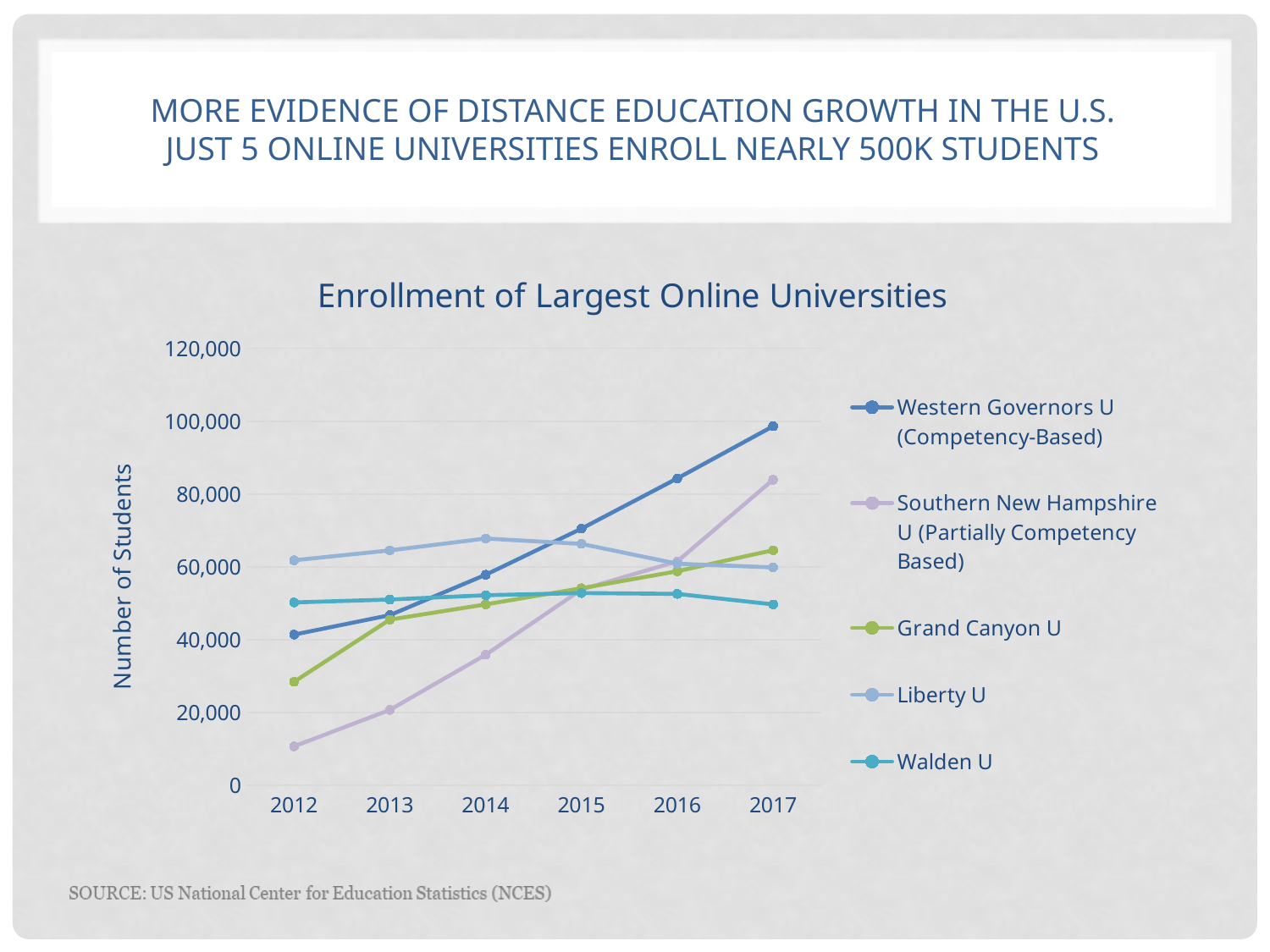
What is the title of the chart? Enrollment of Largest Online Universities Which university has the highest enrollment in 2017? Western Governors U (Competency-Based) What is the label on the y axis? Number of Students Which university has the lowest enrollment in 2012? Southern New Hampshire U (Partially Competency Based) Which university has the highest enrollment in 2012? Liberty U Is the value for Southern New Hampshire U in 2012 greater or less than 20,000? less How many years are shown on the x axis? 6 Is the value for Western Governors U in 2017 greater or less than 80,000? greater What kind of chart is shown on the slide? Line chart How many series does the legend list? 5 In 2016, which has the larger enrollment: Western Governors U or Southern New Hampshire U? Western Governors U Does the enrollment of Western Governors U rise or fall from 2012 to 2017? rise